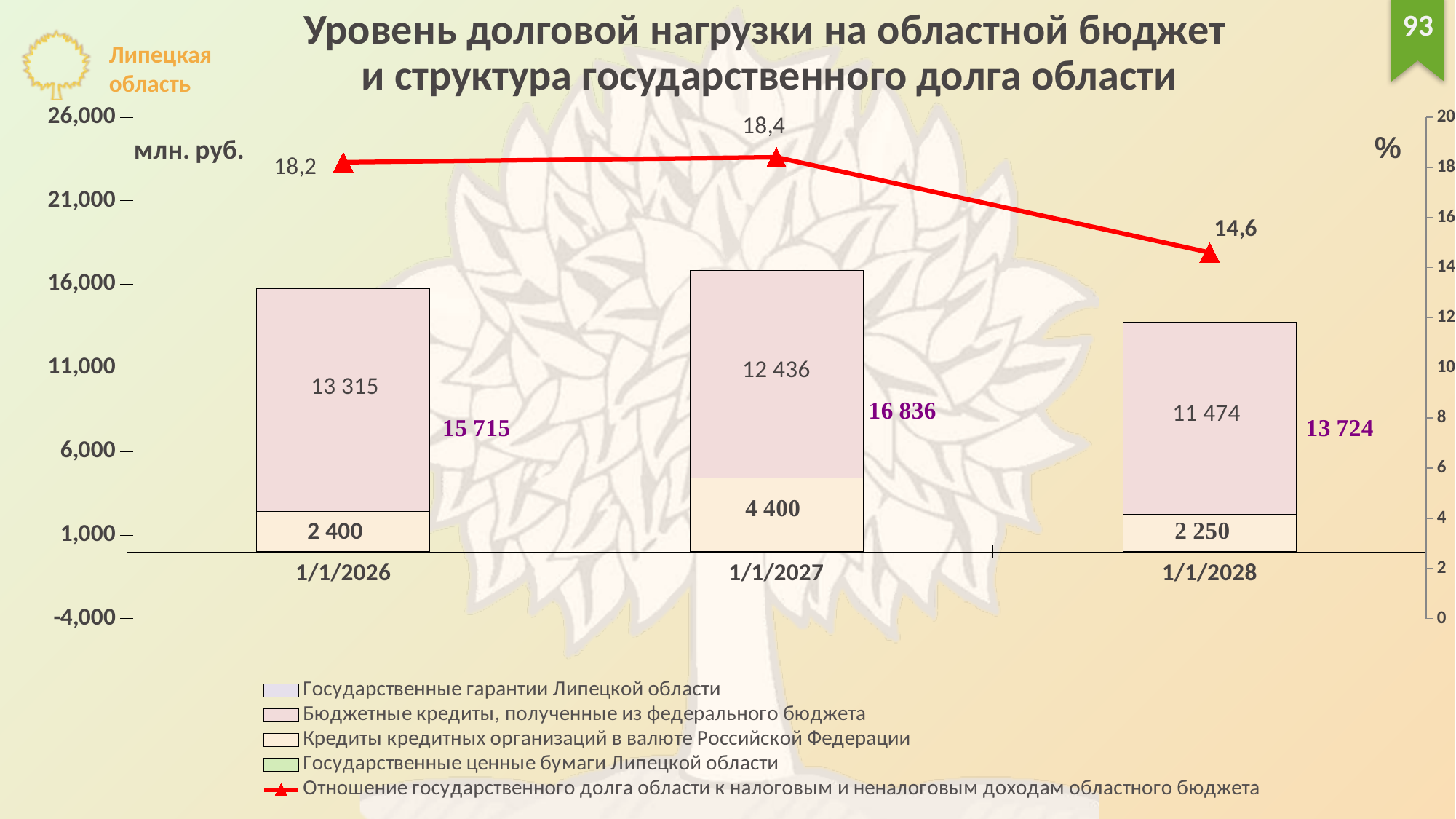
Which date has the lowest value for the 'Кредиты кредитных организаций в валюте Российской Федерации' segment? 1/1/2028 What is the total of the stacked bar for 1/1/2027? 16 836 What is the value of the 'Кредиты кредитных организаций в валюте Российской Федерации' segment for 1/1/2026? 2 400 What is the value of the debt-to-revenue ratio line ('Отношение государственного долга области к налоговым и неналоговым доходам областного бюджета') for 1/1/2028? 14,6 What is the value of the 'Бюджетные кредиты, полученные из федерального бюджета' segment for 1/1/2027? 12 436 What unit is shown on the left axis of the chart? млн. руб. How many dates are shown on the x axis? 3 What is the difference between the 'Бюджетные кредиты, полученные из федерального бюджета' values for 1/1/2026 and 1/1/2028? 1 841 How many entries does the legend list? 5 Does the debt-to-revenue ratio line rise or fall between 1/1/2027 and 1/1/2028? fall Which date has the highest total stacked bar value? 1/1/2027 Which is larger: the 'Кредиты кредитных организаций в валюте Российской Федерации' value for 1/1/2027 or for 1/1/2026? 1/1/2027